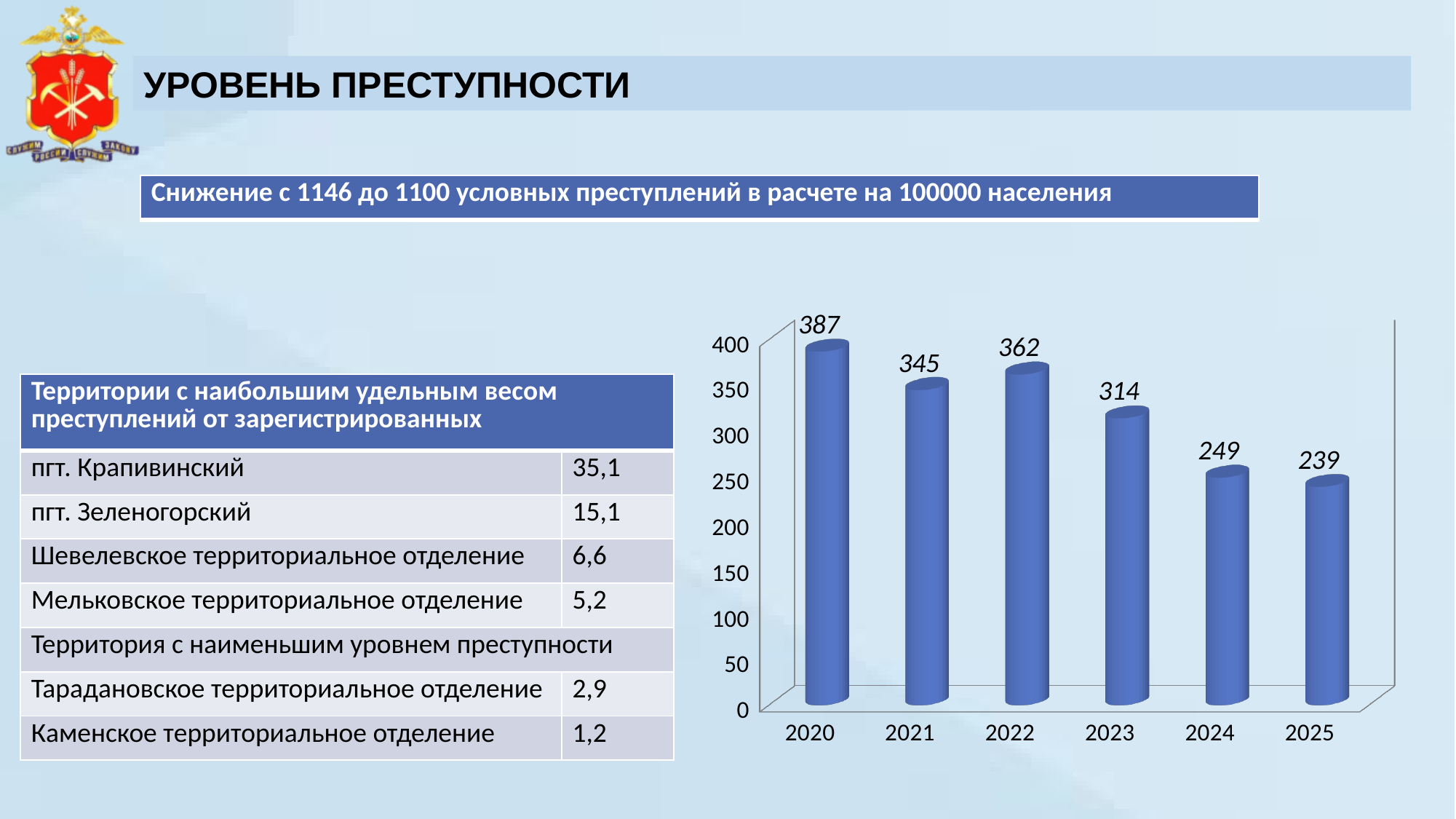
Which year has the highest value in the bar chart? 2020 What is the difference between the values for 2020 and 2025 in the bar chart? 148 What is the value for 2020 in the bar chart? 387 What is the difference between the values for 2022 and 2023 in the bar chart? 48 How many years are shown on the x axis of the bar chart? 6 What is the value for 2023 in the bar chart? 314 Is the value for 2024 in the bar chart greater or less than 300? less What is the value for 2025 in the bar chart? 239 Which is larger in the bar chart, the value for 2021 or the value for 2022? 2022 What kind of chart is shown on the right side of the slide? bar chart Which year has the lowest value in the bar chart? 2025 Do the values in the bar chart generally rise or fall from 2020 to 2025? fall